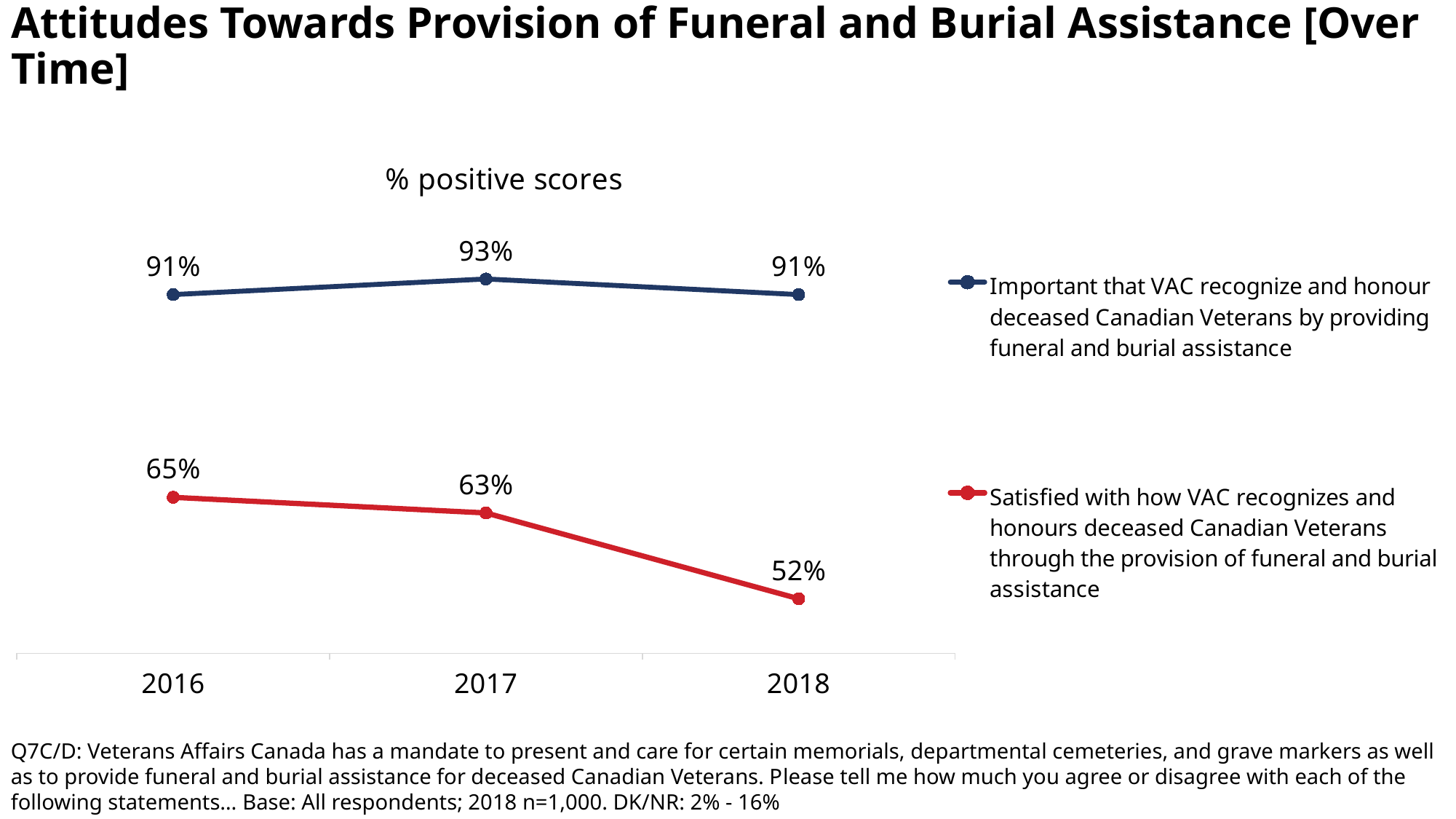
Does the 'Satisfied with how VAC recognizes and honours deceased Canadian Veterans' series rise or fall from 2016 to 2018? Fall What is the % positive score in 2018 for 'Satisfied with how VAC recognizes and honours deceased Canadian Veterans through the provision of funeral and burial assistance'? 52% Which series has the higher value in 2016? Important that VAC recognize and honour deceased Canadian Veterans by providing funeral and burial assistance What kind of chart is shown on the slide? Line chart In which year is the 'Important that VAC recognize and honour deceased Canadian Veterans' series highest? 2017 What is the % positive score in 2017 for 'Important that VAC recognize and honour deceased Canadian Veterans by providing funeral and burial assistance'? 93% How many years are shown on the x axis? 3 In which year is the 'Satisfied with how VAC recognizes and honours deceased Canadian Veterans' series lowest? 2018 What is the difference between the two series in 2018? 39 percentage points How many series does the legend list? 2 What is the % positive score in 2016 for the 'Satisfied with how VAC recognizes and honours deceased Canadian Veterans' series? 65% By how many percentage points did the 'Satisfied' series fall from 2017 to 2018? 11 percentage points